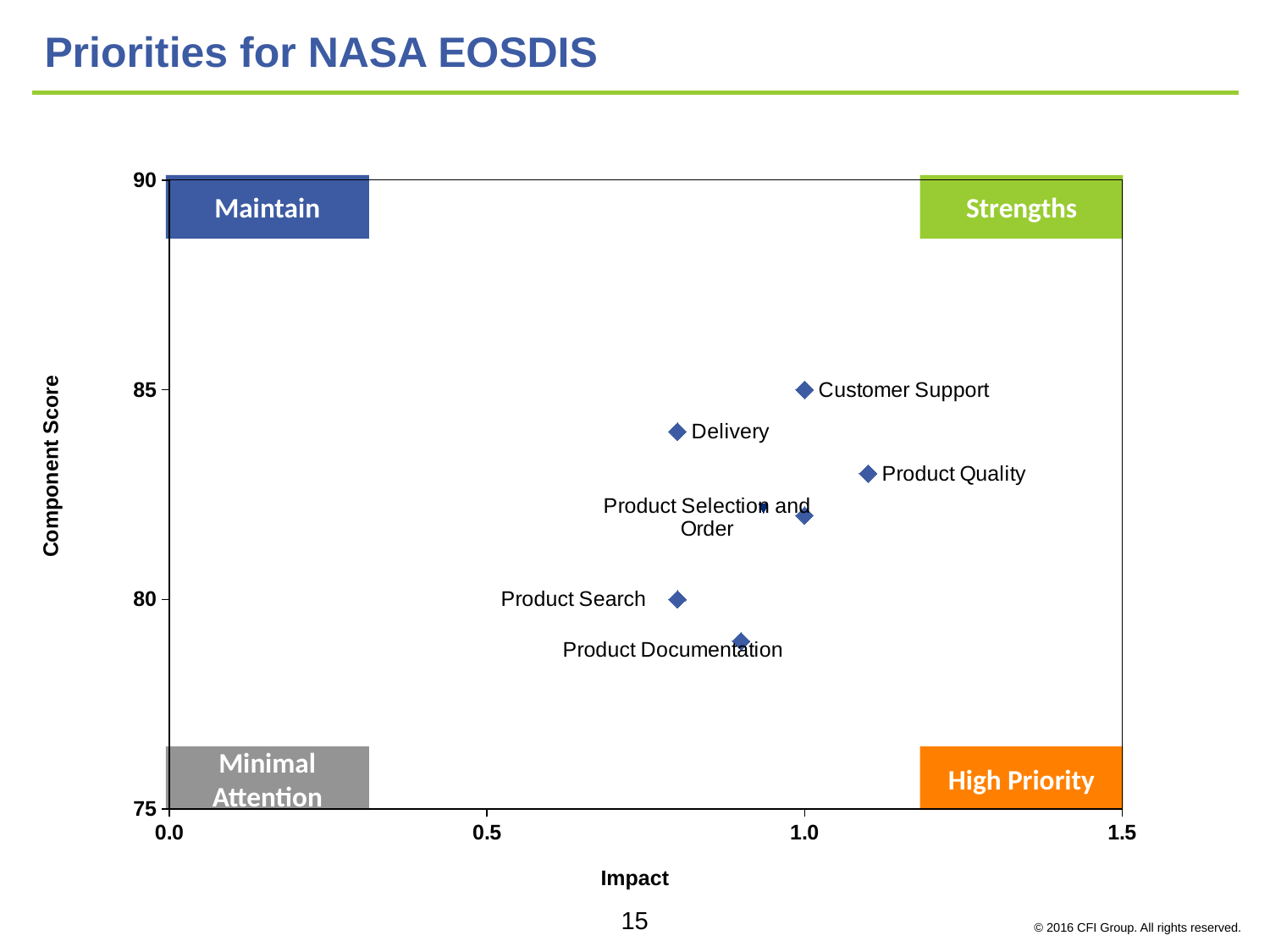
How many data points are plotted on the chart? 6 Is the Impact value for Product Quality greater or less than 1.0? greater Is the Component Score for Product Quality greater or less than 80? greater Which component has the lowest Component Score? Product Documentation Which component has the highest Component Score? Customer Support Is the Component Score for Product Documentation greater or less than 80? less What kind of chart is shown on the slide? scatter chart Which has a higher Impact, Product Quality or Product Search? Product Quality What is the label on the x axis of the chart? Impact Which has a higher Component Score, Delivery or Product Search? Delivery What is the label of the orange quadrant box in the bottom right of the chart? High Priority